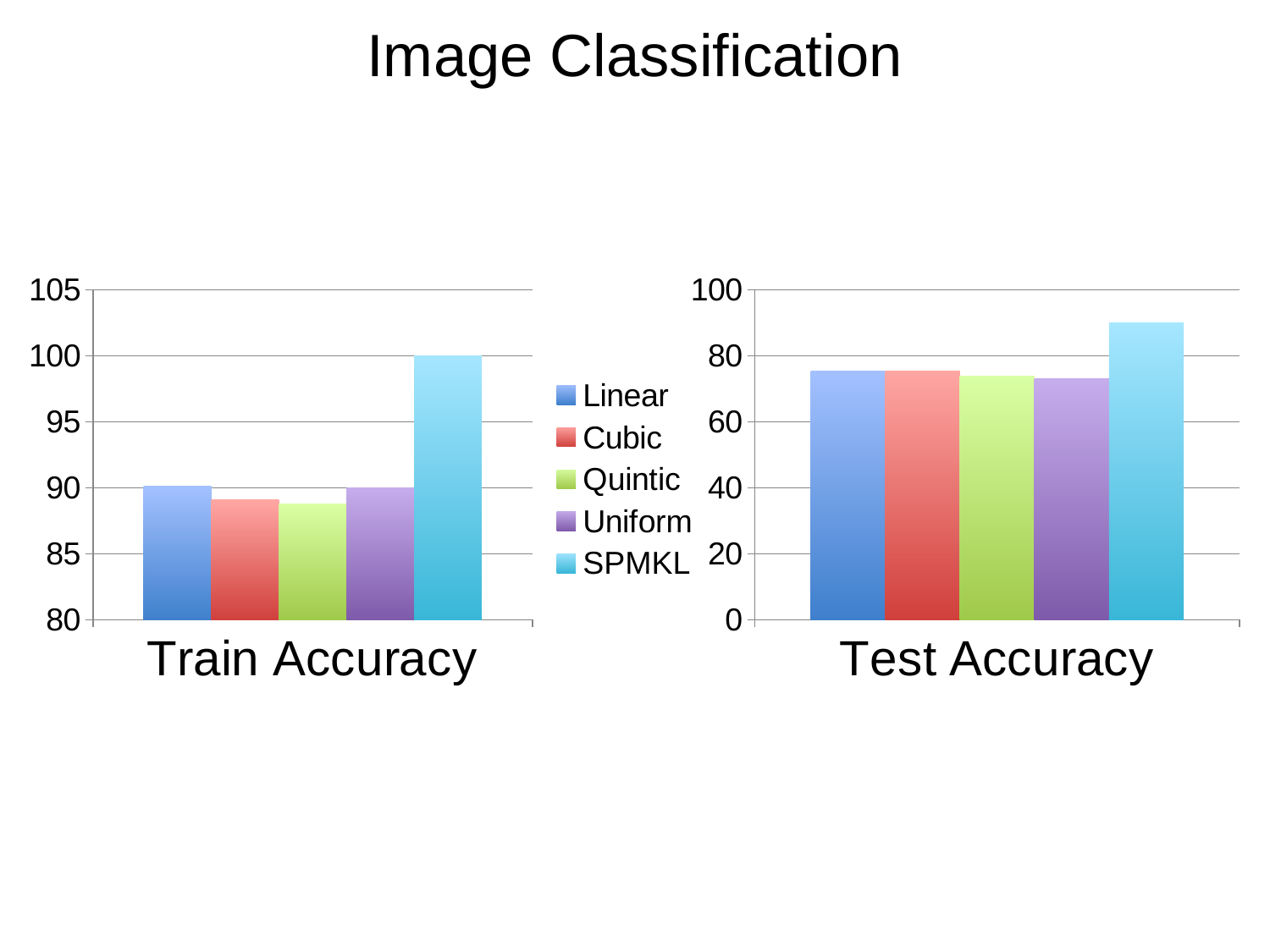
In the Train Accuracy chart, which series has the highest value? SPMKL In the Train Accuracy chart, which is larger, Linear or Quintic? Linear What kind of chart is the Train Accuracy chart? bar chart In the Train Accuracy chart, is the value for Quintic greater or less than 90? less What is the title of the slide above the two charts? Image Classification How many series does the legend list? 5 In the Train Accuracy chart, what is the value for SPMKL? 100 In the Test Accuracy chart, is the value for Uniform greater or less than 80? less In the Test Accuracy chart, which is larger, Linear or Uniform? Linear In the Test Accuracy chart, which series has the highest value? SPMKL How many bars are shown in the Test Accuracy chart? 5 In the Test Accuracy chart, is the value for SPMKL greater or less than 80? greater